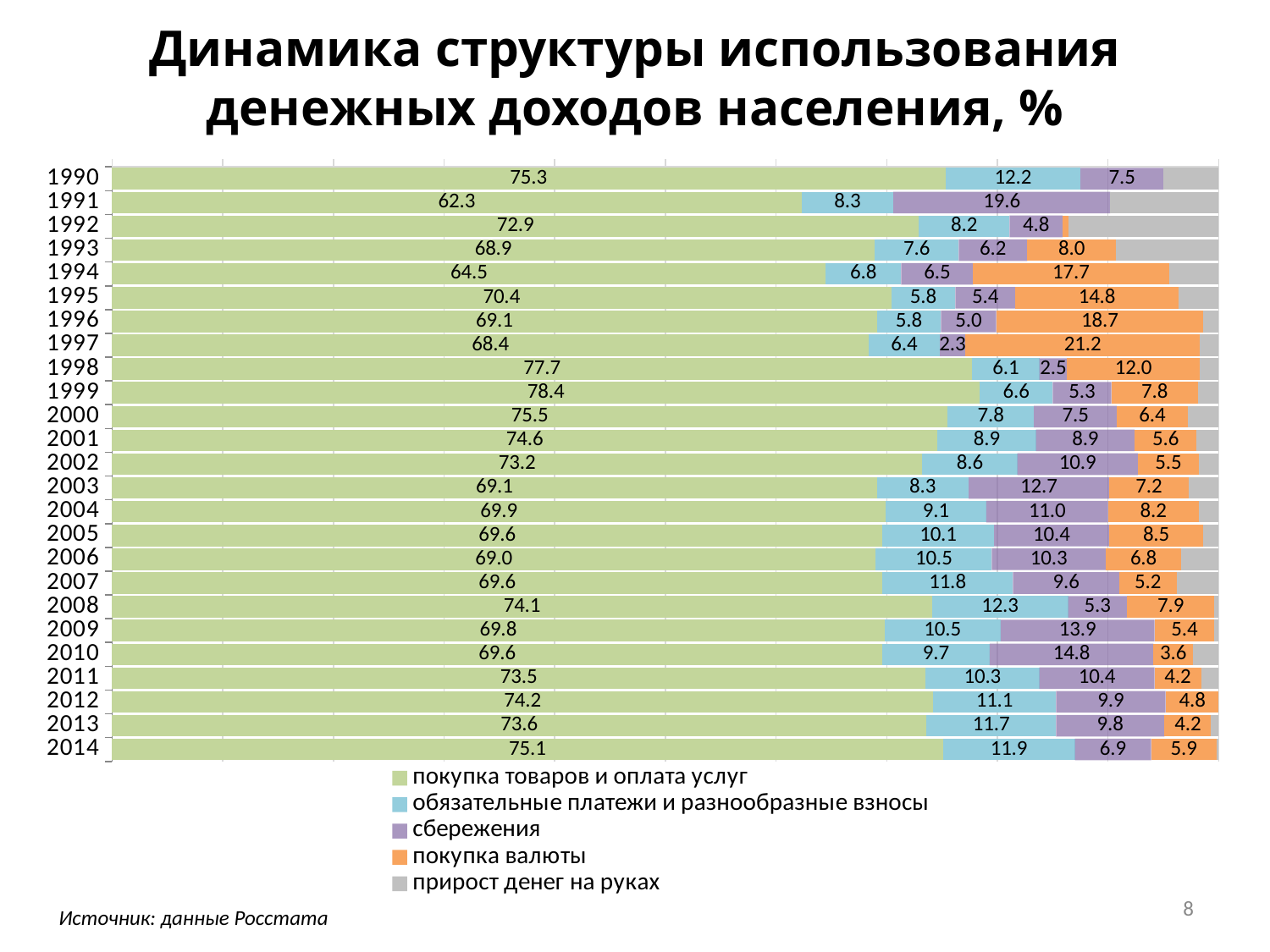
What is the value for покупка валюты in 1997? 21.2 In which year is the share of покупка товаров и оплата услуг the lowest? 1991 What is the difference between the покупка товаров и оплата услуг values for 1999 and 1991? 16.1 What is the value for обязательные платежи и разнообразные взносы in 2014? 11.9 What is the value for покупка товаров и оплата услуг in 1990? 75.3 How many years are shown on the chart? 25 Which legend entry is shown in grey? прирост денег на руках What is the value for сбережения in 1991? 19.6 What kind of chart is shown on the slide? Stacked bar chart In which year is the share of покупка товаров и оплата услуг the highest? 1999 How many series does the legend list? 5 Which year has the larger value for сбережения, 1990 or 1991? 1991